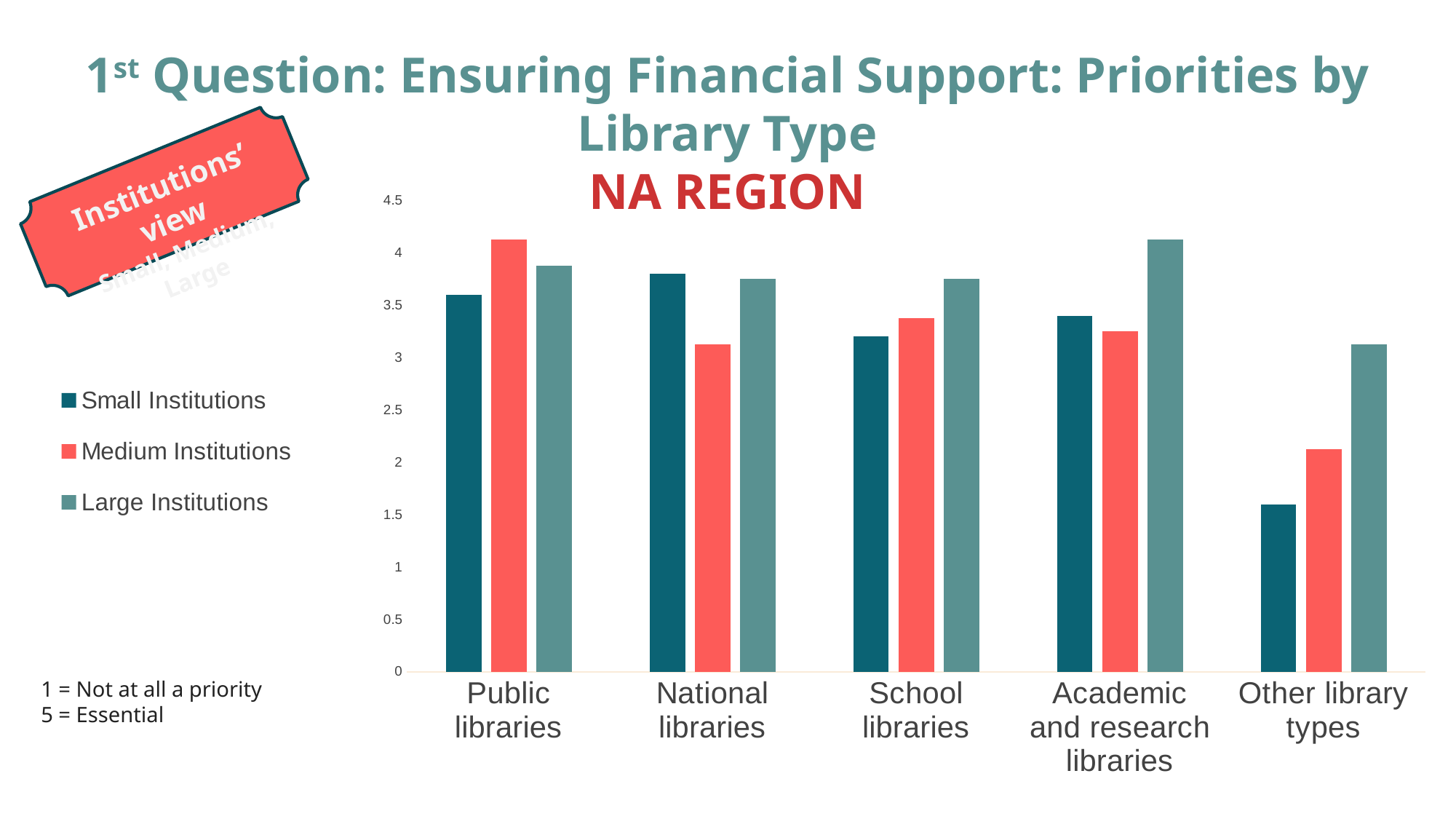
Is the value for Small Institutions for Other library types greater or less than 2? less For Public libraries, which series has the highest value? Medium Institutions For Other library types, which is larger: Large Institutions or Small Institutions? Large Institutions Is the value for Large Institutions for Other library types greater or less than 2.5? greater For National libraries, which series has the lowest value? Medium Institutions Is the value for Medium Institutions for Public libraries greater or less than 3.5? greater How many library type categories are shown on the x axis? 5 What region does the chart title say the data is for? NA REGION For National libraries, which is larger: Small Institutions or Medium Institutions? Small Institutions What kind of chart is shown on the slide? Bar chart How many series does the legend list? 3 Which bar is the lowest in the whole chart? Small Institutions for Other library types